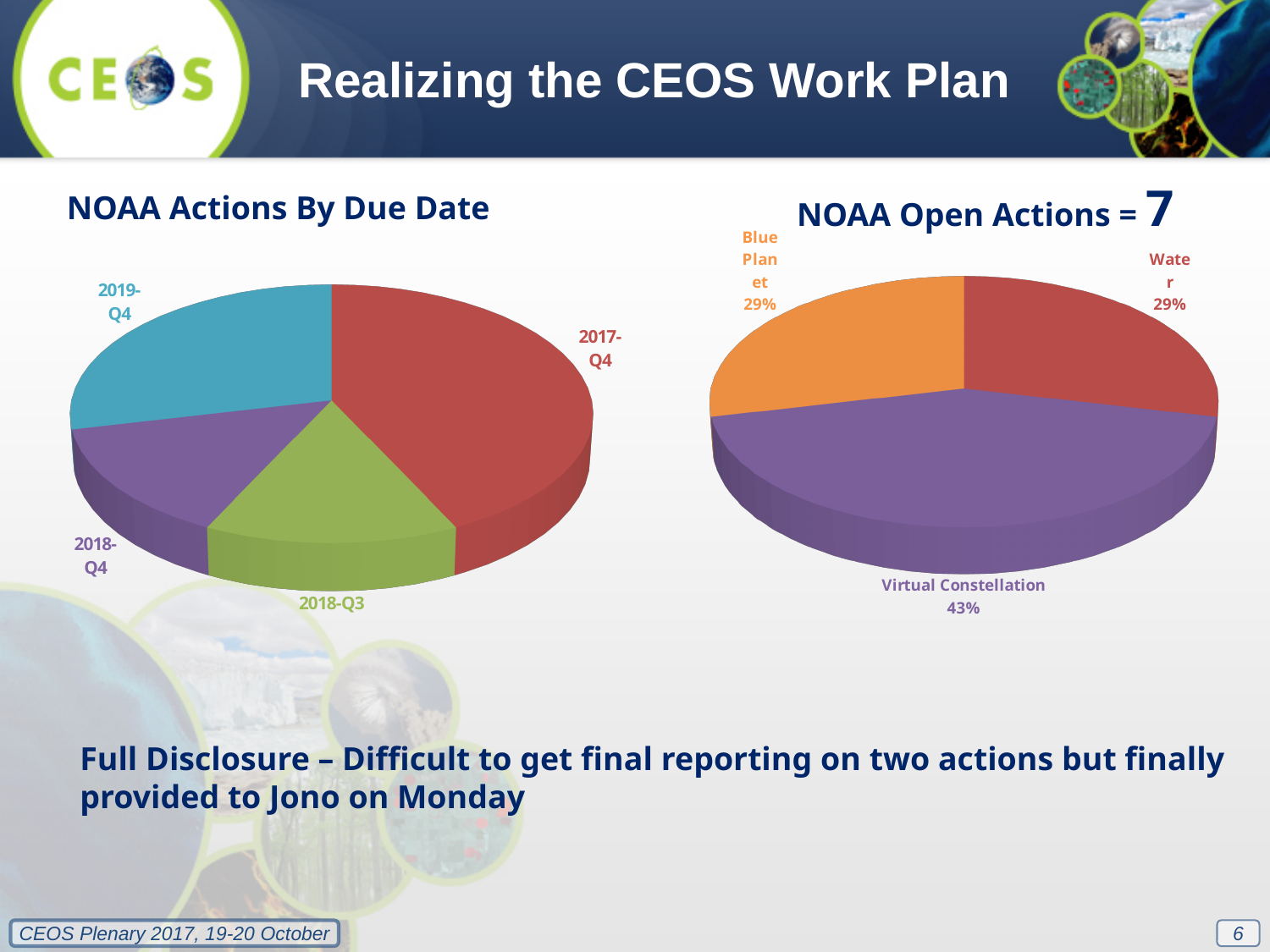
In the 'NOAA Open Actions = 7' chart, what is the difference in percentage points between Virtual Constellation and Blue Planet? 14 What type of chart is the 'NOAA Open Actions = 7' chart on the right? pie chart In the 'NOAA Open Actions = 7' chart, what share does Virtual Constellation have? 43% In the 'NOAA Open Actions = 7' chart, which category has the largest share? Virtual Constellation What type of chart is the 'NOAA Actions By Due Date' chart on the left? pie chart In the 'NOAA Actions By Due Date' chart, which due-date category has the largest slice? 2017-Q4 In the 'NOAA Open Actions = 7' chart, which is larger, Virtual Constellation or Water? Virtual Constellation In the 'NOAA Open Actions = 7' chart, how many slices are shown? 3 In the 'NOAA Actions By Due Date' chart, how many due-date categories are shown? 4 In the 'NOAA Open Actions = 7' chart, what share does Water have? 29% According to the title of the right-hand chart, how many NOAA open actions are there? 7 In the 'NOAA Open Actions = 7' chart, what share does Blue Planet have? 29%